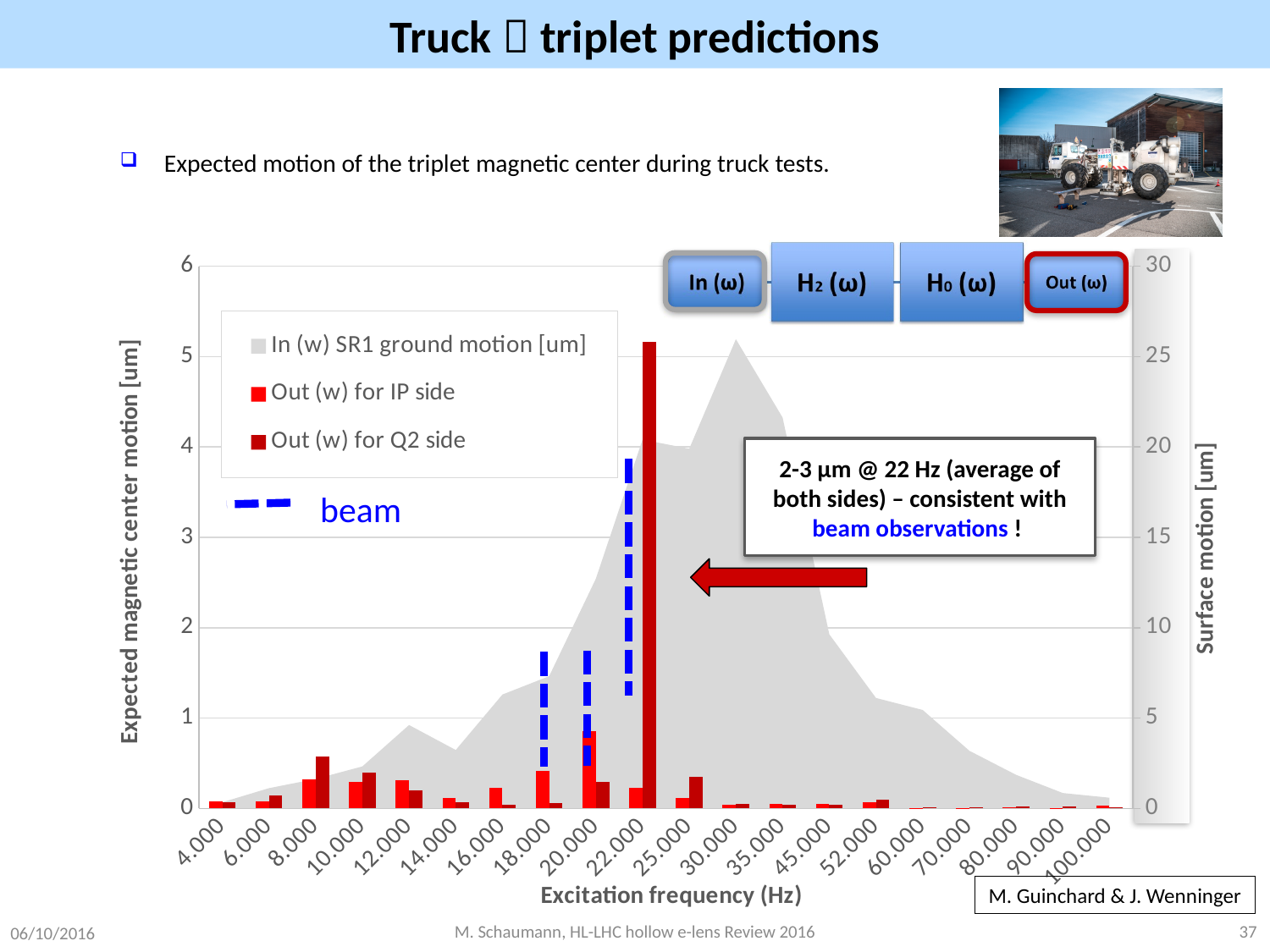
Which has the larger Out (w) for Q2 side value, 6.000 Hz or 8.000 Hz? 8.000 How many excitation frequency categories are shown on the x axis? 20 What is the title of the x axis of the chart? Excitation frequency (Hz) How many series does the chart legend list? 3 At which excitation frequency is the Out (w) for Q2 side bar highest? 22.000 Is the Out (w) for IP side value at 20.000 Hz greater or less than 1 on the left axis? less Which has the larger Out (w) for IP side value, 18.000 Hz or 20.000 Hz? 20.000 At which excitation frequency does the In (w) SR1 ground motion series reach its peak? 30.000 What kind of chart is used to plot the Out (w) for IP side and Out (w) for Q2 side series? bar chart What is the first entry listed in the chart legend? In (w) SR1 ground motion [um] Is the Out (w) for Q2 side value at 22.000 Hz greater or less than 4 on the left axis? greater